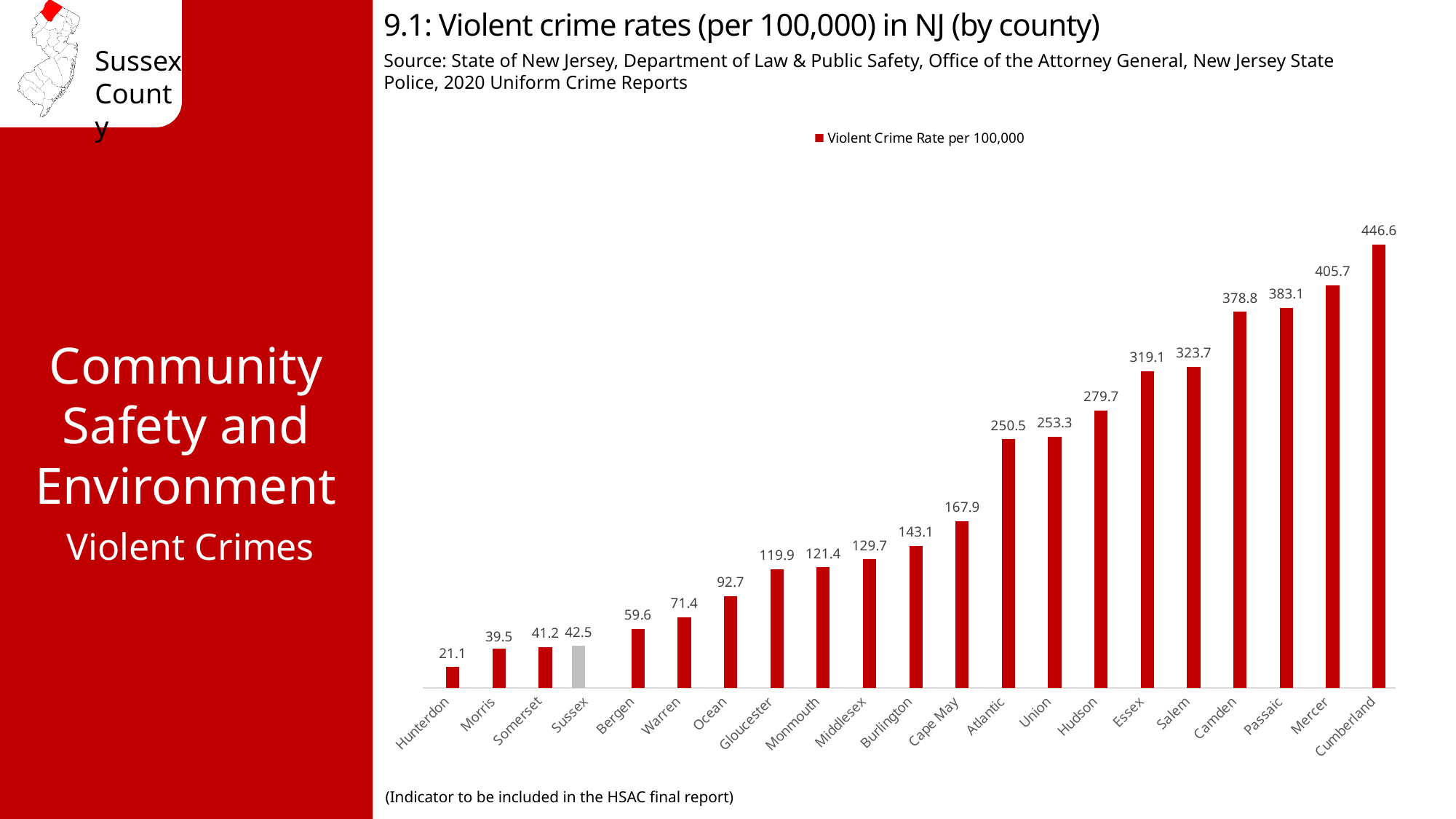
What is the violent crime rate per 100,000 for Hudson County? 279.7 What is the violent crime rate per 100,000 for Sussex County? 42.5 Do the violent crime rates rise or fall from left to right along the x axis? Rise Which county has the lowest violent crime rate? Hunterdon What is the difference between the violent crime rates of Cumberland and Hunterdon? 425.5 How many counties are shown on the chart? 21 How many series does the legend list? 1 What kind of chart is shown on the slide? Bar chart What is the violent crime rate per 100,000 for Cape May County? 167.9 Which county has a higher violent crime rate, Essex or Camden? Camden What is the difference between the violent crime rates of Sussex and Morris? 3.0 Which county has the highest violent crime rate? Cumberland